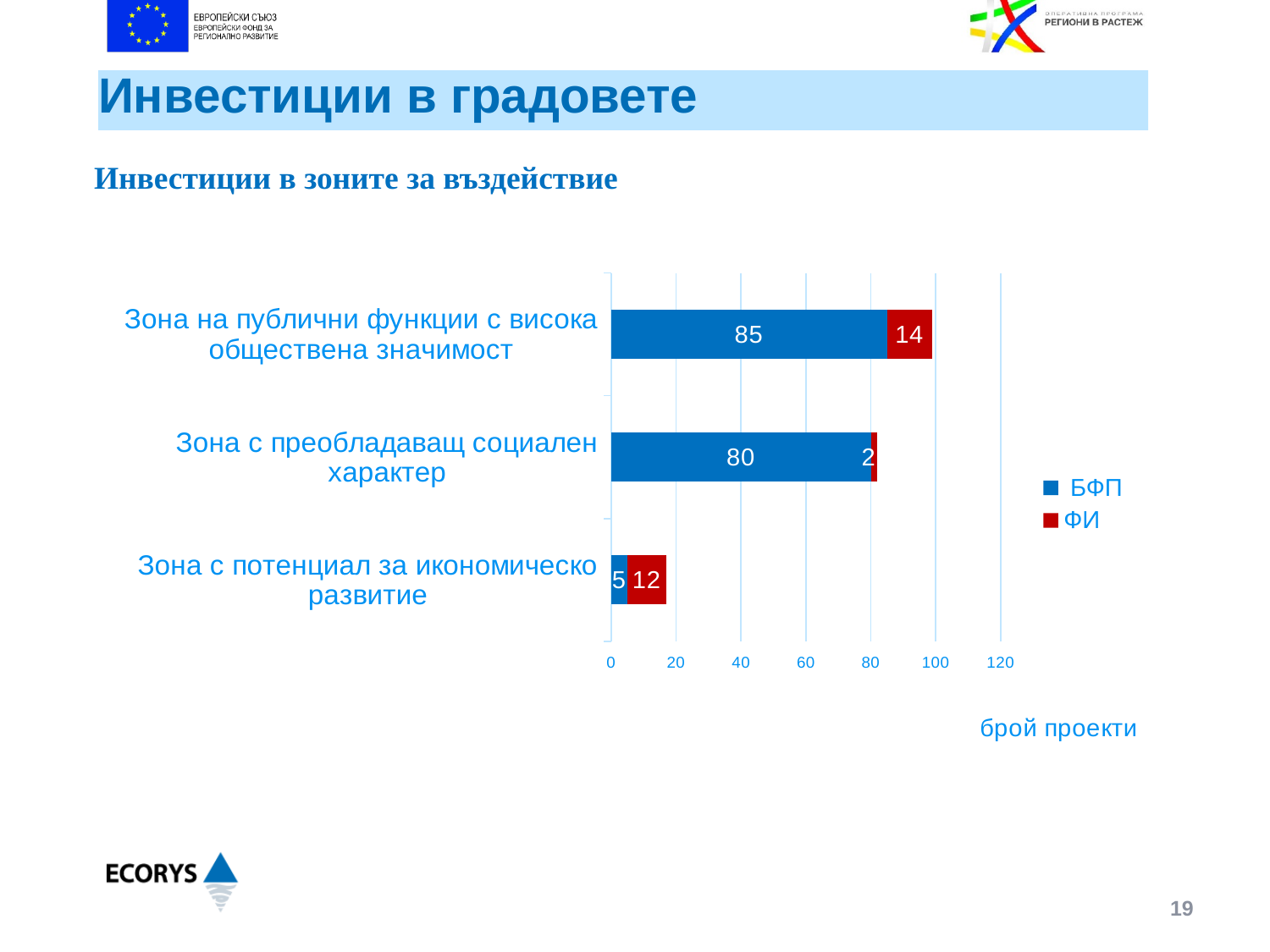
How many series does the legend list? 2 What is the total number of projects (БФП plus ФИ) for 'Зона с потенциал за икономическо развитие'? 17 What kind of chart is shown on the slide? Stacked bar chart What is the ФИ value for 'Зона с преобладаващ социален характер'? 2 Which is larger: the БФП value for 'Зона с преобладаващ социален характер' or the БФП value for 'Зона с потенциал за икономическо развитие'? Зона с преобладаващ социален характер What is the БФП value for 'Зона на публични функции с висока обществена значимост'? 85 What is the ФИ value for 'Зона с потенциал за икономическо развитие'? 12 How many zones (categories) are shown in the chart? 3 What is the difference between the ФИ values for 'Зона на публични функции с висока обществена значимост' and 'Зона с преобладаващ социален характер'? 12 Which zone has the lowest БФП value? Зона с потенциал за икономическо развитие Which zone has the highest БФП value? Зона на публични функции с висока обществена значимост What is the total number of projects (БФП plus ФИ) for 'Зона на публични функции с висока обществена значимост'? 99